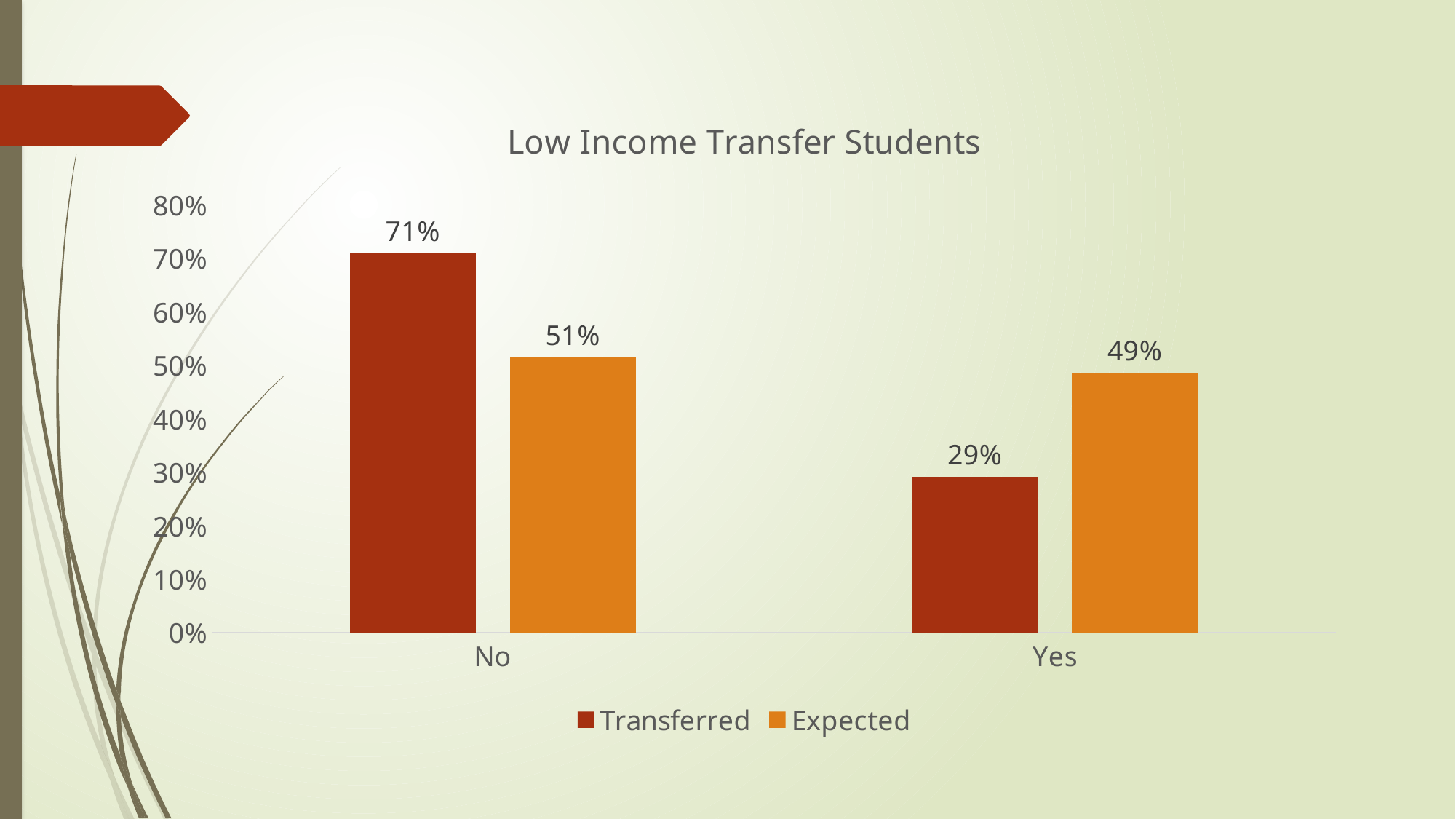
What is the difference between the Transferred and Expected values for the No category? 20% What is the Expected value for the Yes category? 49% Which category has the highest Transferred value? No What is the Transferred value for the No category? 71% What is the Expected value for the No category? 51% What kind of chart is shown on the slide? Bar chart What is the Transferred value for the Yes category? 29% Which category has the lowest Expected value? Yes How many series does the legend list? 2 For the Yes category, which is larger: Transferred or Expected? Expected What is the difference between the Expected and Transferred values for the Yes category? 20% How many categories are shown on the x axis? 2